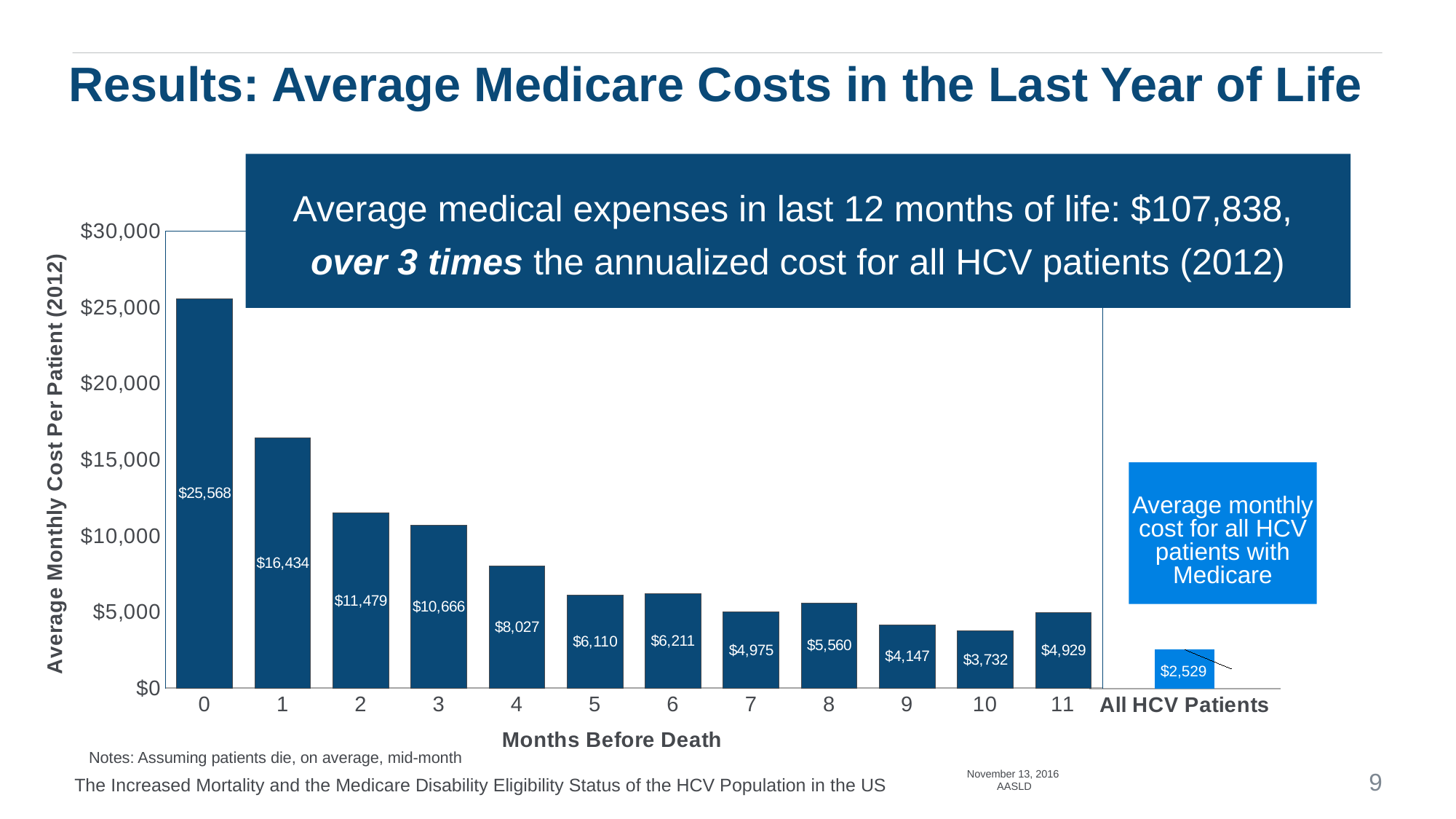
Do the average monthly costs generally rise or fall from 0 to 11 months before death? Fall Which category has the highest average monthly cost per patient? 0 months before death Which is larger, the average monthly cost at 7 months or at 8 months before death? 8 months before death What is the difference between the average monthly cost at 0 months and at 1 month before death? $9,134 What is the average monthly cost for All HCV Patients? $2,529 Which category has the lowest average monthly cost per patient? All HCV Patients How many bars are plotted in the chart? 13 What is the difference between the average monthly cost at 11 months before death and for All HCV Patients? $2,400 What is the average monthly cost per patient at 4 months before death? $8,027 What kind of chart is shown on the slide? Bar chart What is the average monthly cost per patient at 0 months before death? $25,568 Is the average monthly cost at 2 months before death greater or less than $10,000? greater